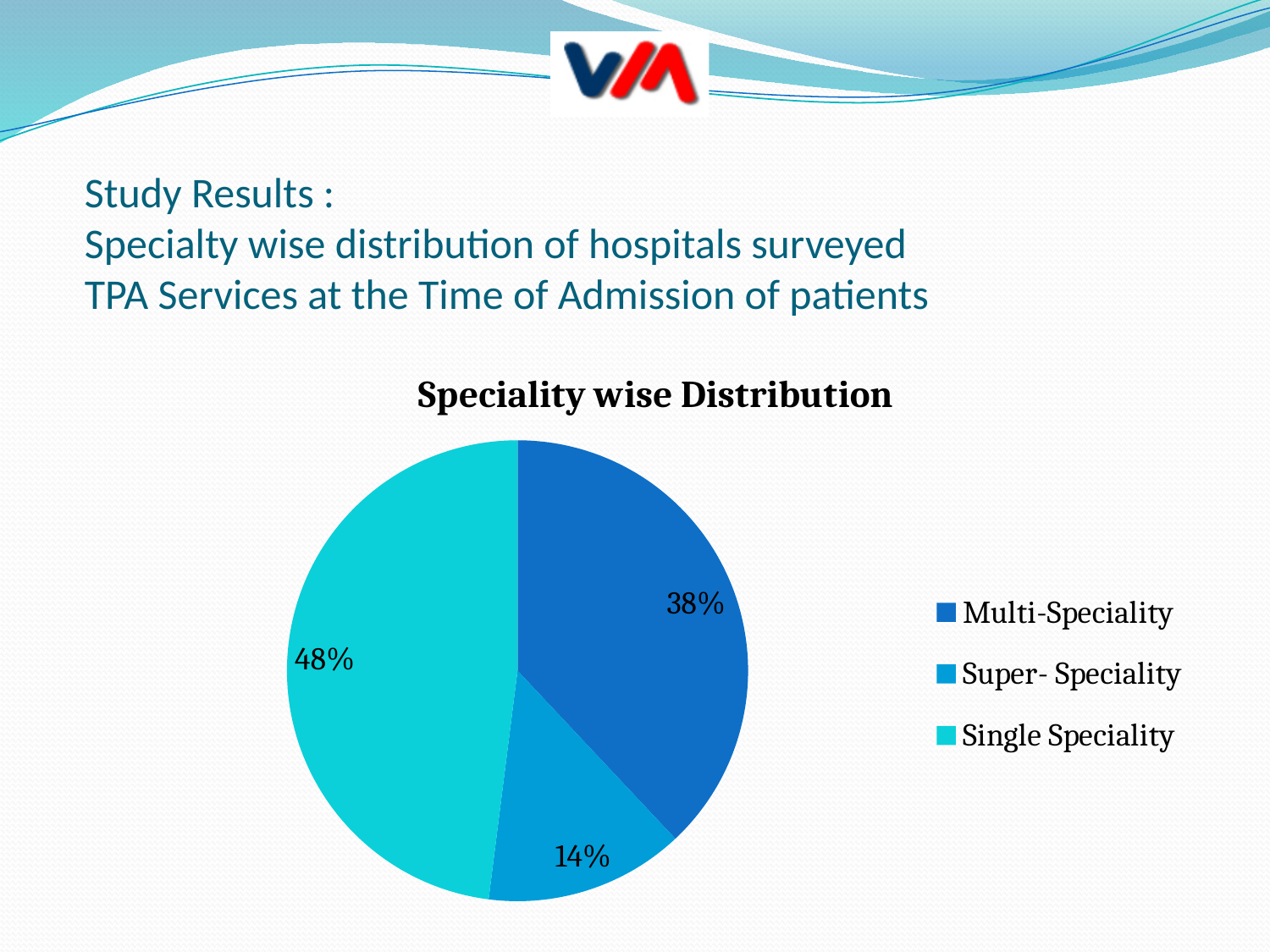
What is the title of the chart? Speciality wise Distribution What is the difference between the Single Speciality and Multi-Speciality shares? 10% How many entries does the legend list? 3 What share of the pie is Super- Speciality? 14% What share of the pie is Multi-Speciality? 38% What is the difference between the Multi-Speciality and Super- Speciality shares? 24% Which category has the largest share of the pie? Single Speciality Which category has the smallest share of the pie? Super- Speciality Which is larger, the Multi-Speciality share or the Super- Speciality share? Multi-Speciality What type of chart is shown on the slide? Pie chart How many categories does the pie chart have? 3 What share of the pie is Single Speciality? 48%